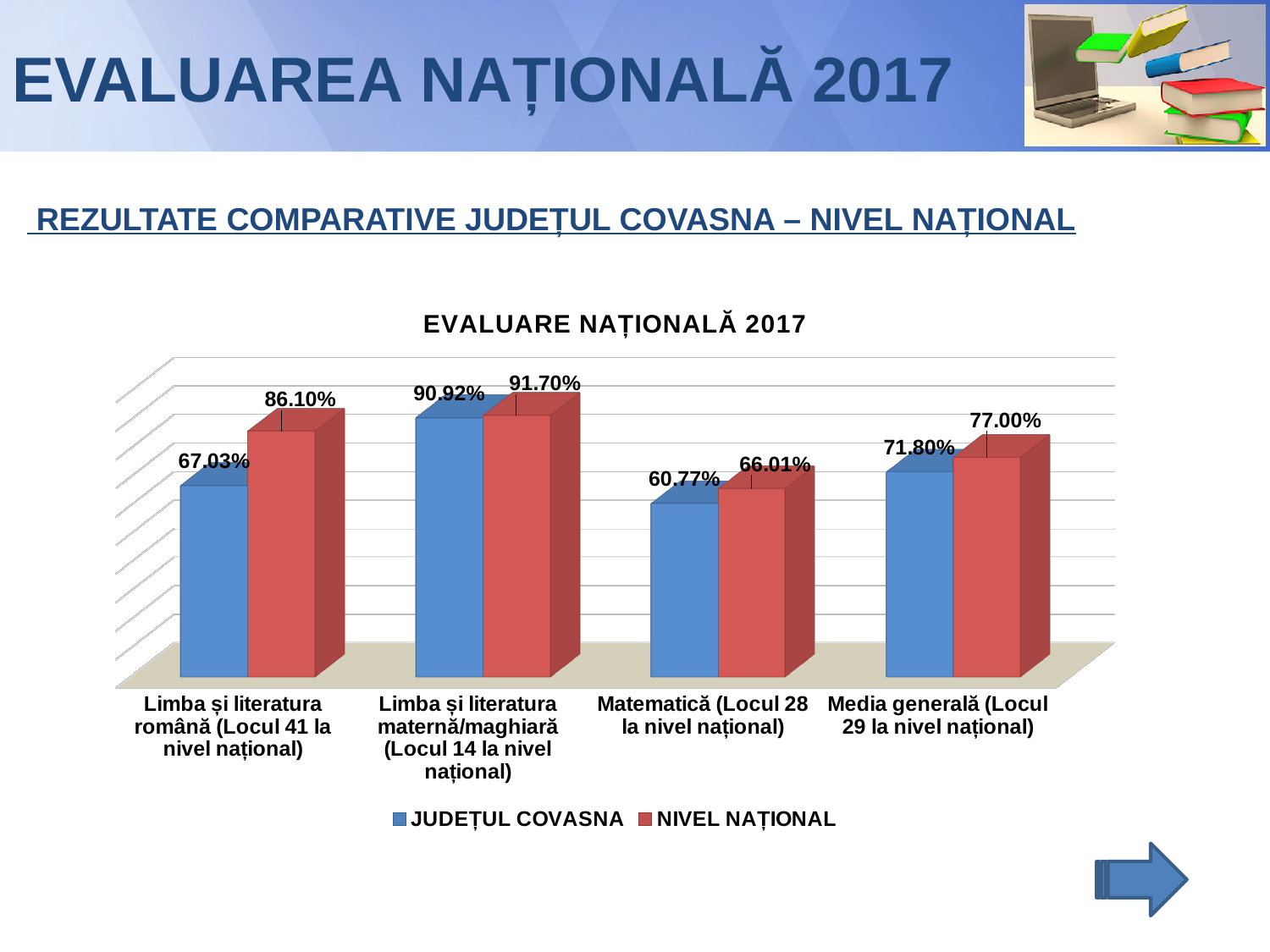
What is the value for JUDEȚUL COVASNA in the Limba și literatura română category? 67.03% How many categories are shown on the x axis of the chart? 4 What is the value for NIVEL NAȚIONAL in the Matematică category? 66.01% What type of chart is shown on the slide? Bar chart What is the difference between the NIVEL NAȚIONAL and JUDEȚUL COVASNA values in the Limba și literatura română category? 19.07% In the Media generală category, which series has the larger value, JUDEȚUL COVASNA or NIVEL NAȚIONAL? NIVEL NAȚIONAL What is the difference between the NIVEL NAȚIONAL and JUDEȚUL COVASNA values in the Matematică category? 5.24% In which category does JUDEȚUL COVASNA have its highest value? Limba și literatura maternă/maghiară In which category does NIVEL NAȚIONAL have its lowest value? Matematică What is the value for NIVEL NAȚIONAL in the Limba și literatura maternă/maghiară category? 91.70% What is the value for JUDEȚUL COVASNA in the Media generală category? 71.80% How many series does the chart legend list? 2